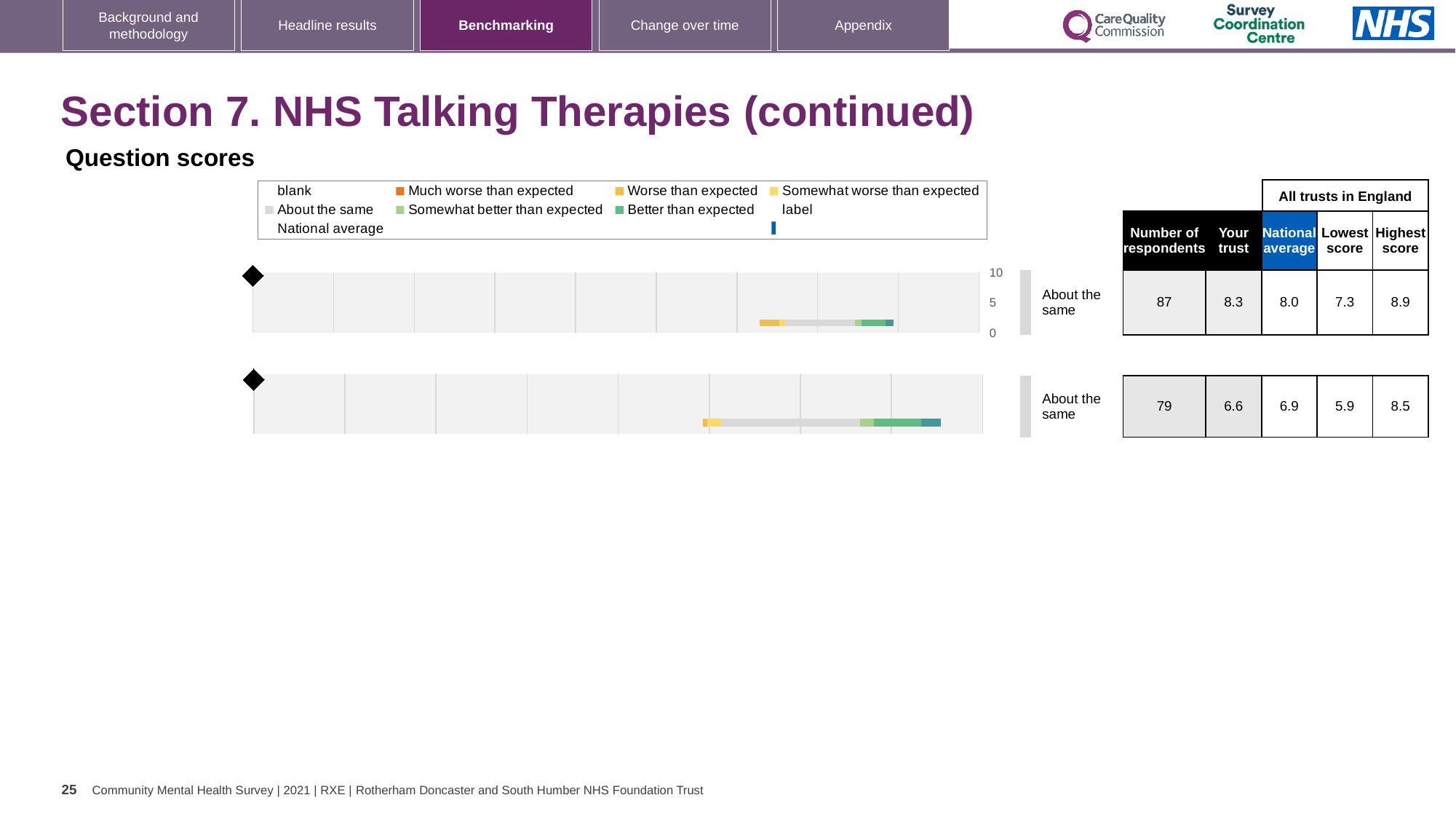
What kind of chart is used to show the question scores on this slide? bar chart In the bottom chart, is the Your trust score higher or lower than the National average? lower In the bottom chart, what is the score for Your trust? 6.6 In the top chart, what is the difference between the Highest score and the Lowest score? 1.6 In the bottom chart, what is the Lowest score among all trusts in England? 5.9 In the bottom chart, what is the Highest score among all trusts in England? 8.5 What benchmark category is shown for both charts on this slide? About the same In the top chart, what is the National average score? 8.0 In the bottom chart, what is the National average score? 6.9 In the top chart, how many respondents are shown? 87 In the top chart, is the Your trust score higher or lower than the National average? higher In the top chart, what is the score for Your trust? 8.3